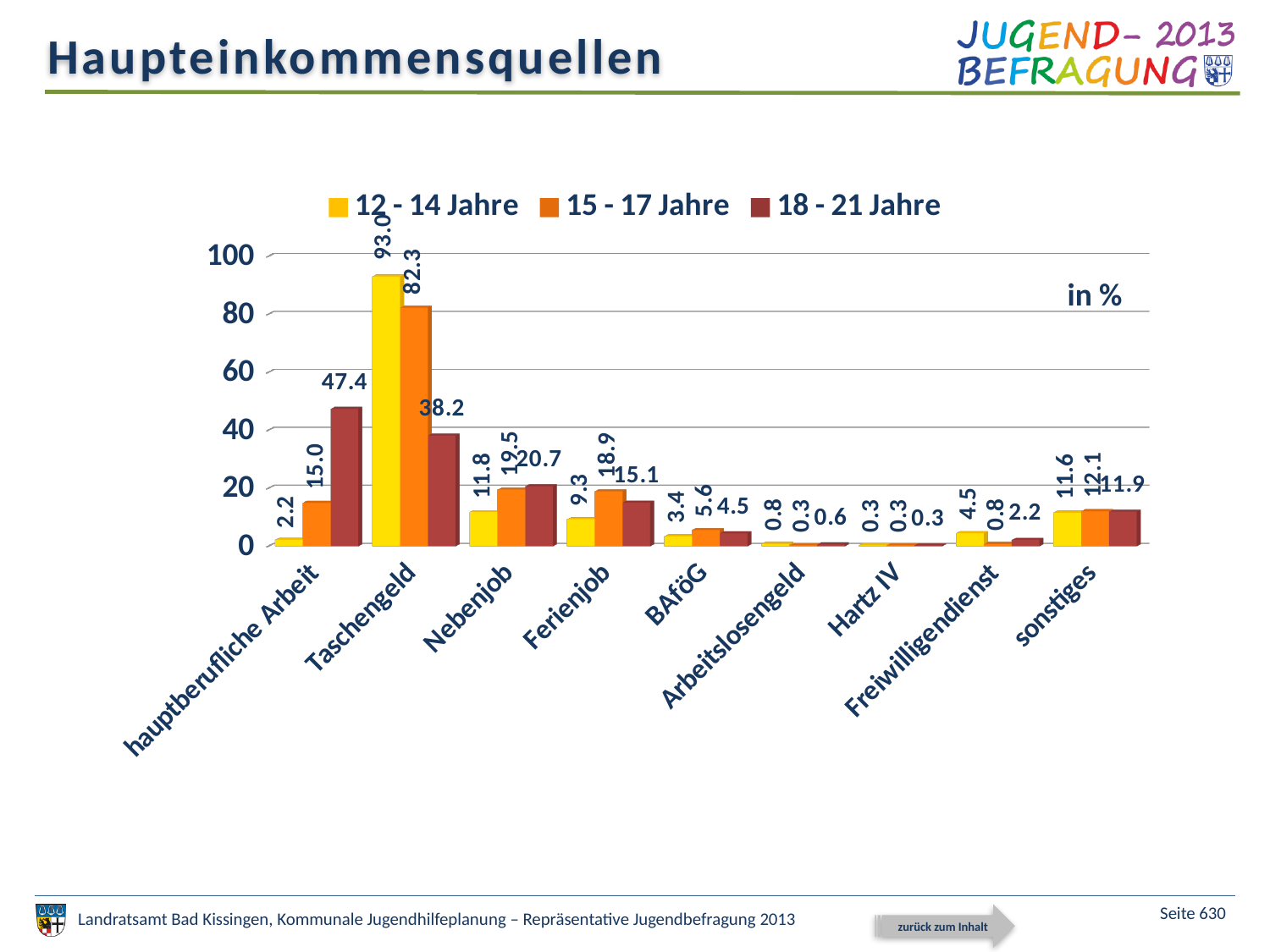
Is the value for Taschengeld in the 15 - 17 Jahre series greater or less than 80? greater What is the value for Nebenjob in the 15 - 17 Jahre series? 19.5 Which category has the highest value in the 18 - 21 Jahre series? hauptberufliche Arbeit What is the title of the slide? Haupteinkommensquellen How many series does the legend list? 3 How many categories are shown on the x axis? 9 For Ferienjob, which is larger: the 15 - 17 Jahre value or the 18 - 21 Jahre value? 15 - 17 Jahre What is the value for Taschengeld in the 12 - 14 Jahre series? 93.0 Which category has the lowest value in the 12 - 14 Jahre series? Hartz IV What kind of chart is shown on the slide? bar chart What is the difference between the 12 - 14 Jahre and 18 - 21 Jahre values for Taschengeld? 54.8 What is the value for hauptberufliche Arbeit in the 18 - 21 Jahre series? 47.4